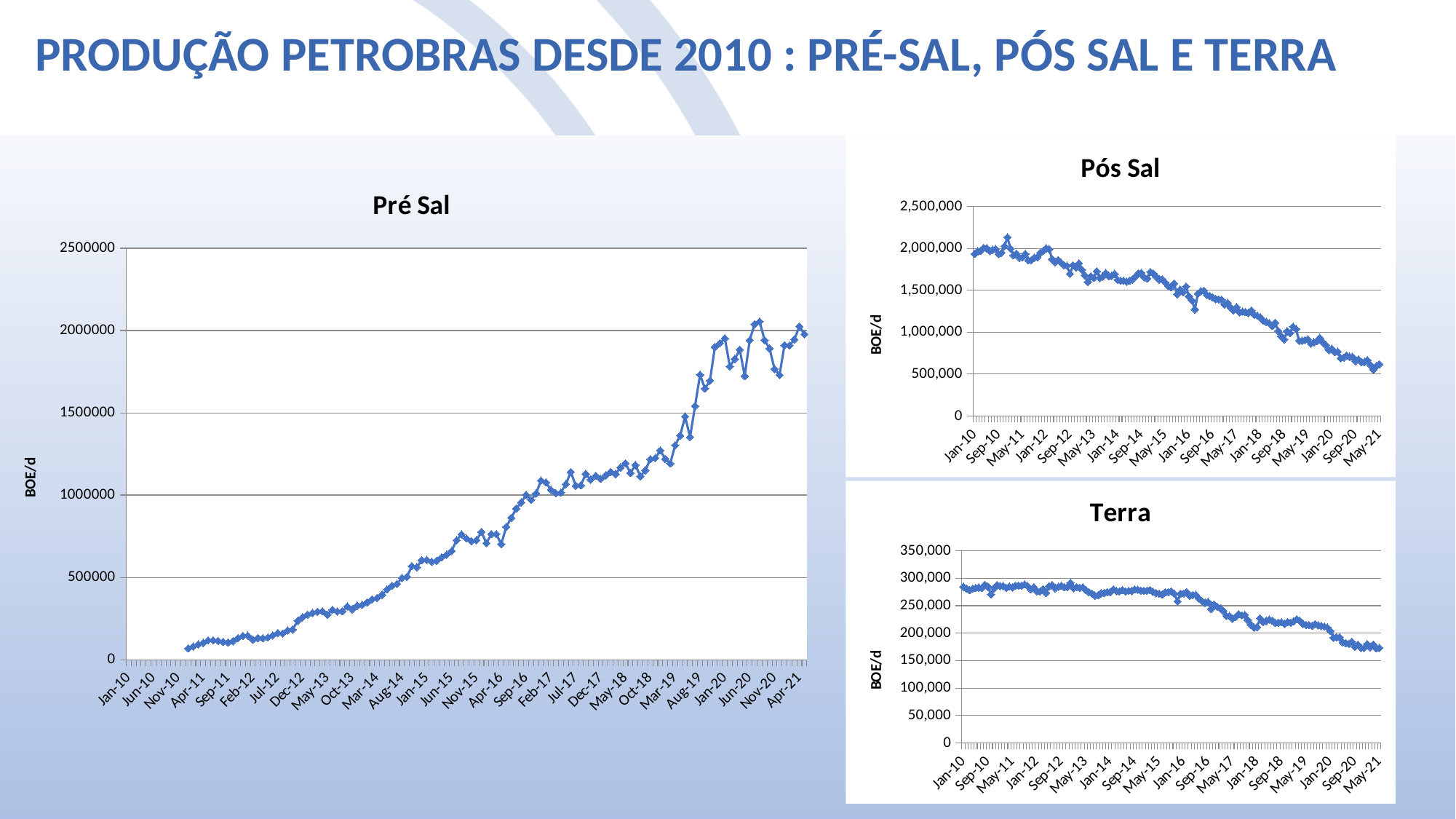
What is the y-axis label of the Terra chart? BOE/d How many charts are shown on the slide? 3 In the Pré Sal chart, is the value at Apr-21 greater or less than 1500000? greater In the Pré Sal chart, do the values generally rise or fall from 2011 to 2021? rise In the Pós Sal chart, is the value at Jan-10 greater or less than 1,500,000? greater In the Terra chart, do the values generally rise or fall from Jan-10 to May-21? fall In the Terra chart, is the value at May-21 greater or less than 200,000? less In the Pós Sal chart, do the values generally rise or fall from Jan-10 to May-21? fall What kind of chart is the Pré Sal chart? line chart